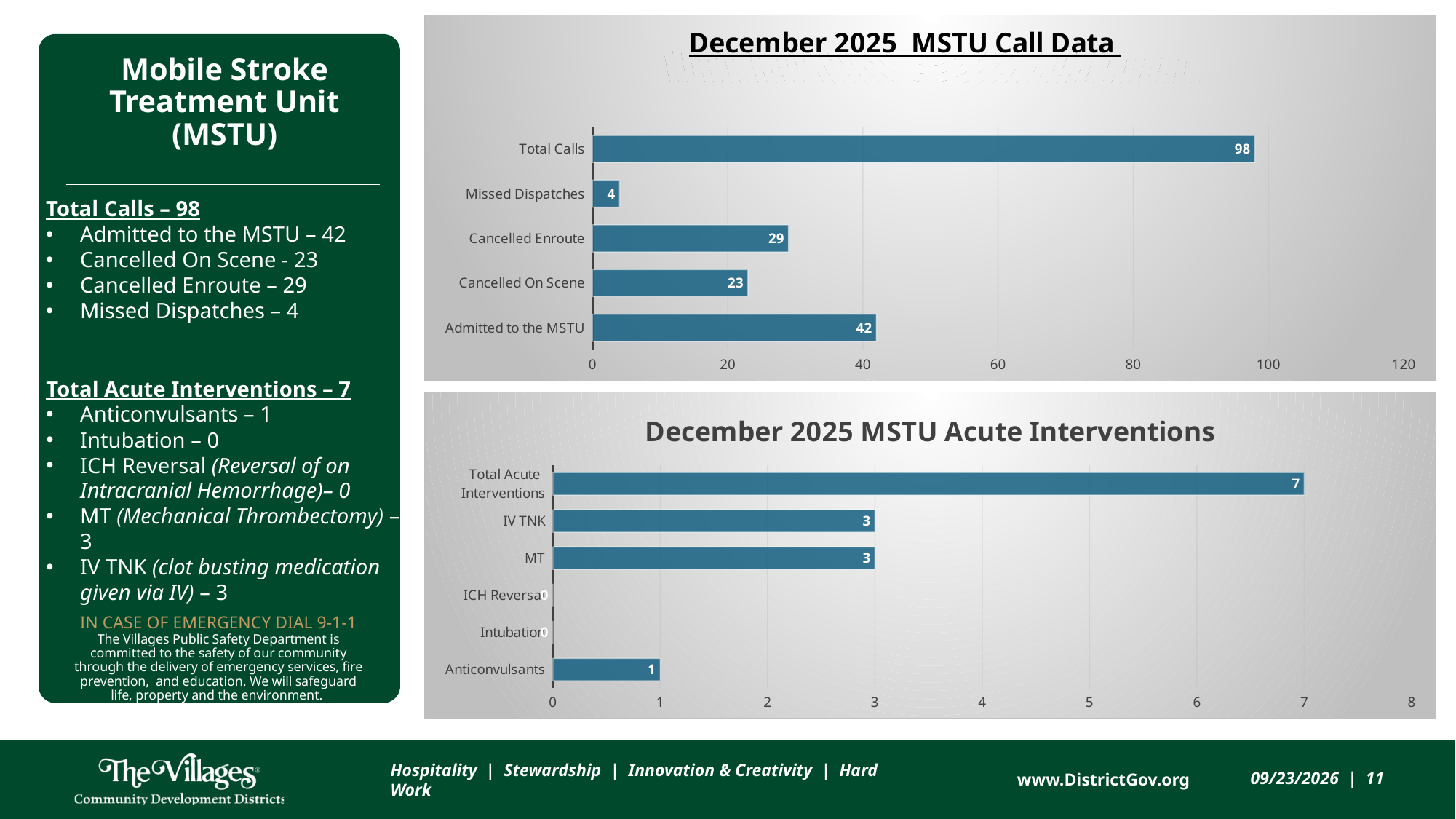
How many categories are shown in the December 2025 MSTU Acute Interventions chart? 6 In the December 2025 MSTU Call Data chart, which category has the lowest value? Missed Dispatches In the December 2025 MSTU Call Data chart, what is the value for Cancelled Enroute? 29 In the December 2025 MSTU Acute Interventions chart, what is the difference between Total Acute Interventions and MT? 4 In the December 2025 MSTU Acute Interventions chart, what is the value for Anticonvulsants? 1 In the December 2025 MSTU Acute Interventions chart, what is the value for IV TNK? 3 In the December 2025 MSTU Call Data chart, what is the difference between Admitted to the MSTU and Cancelled On Scene? 19 In the December 2025 MSTU Acute Interventions chart, what is the value for Total Acute Interventions? 7 How many categories are shown in the December 2025 MSTU Call Data chart? 5 What kind of chart is the December 2025 MSTU Call Data chart? Bar chart In the December 2025 MSTU Call Data chart, what is the value for Total Calls? 98 In the December 2025 MSTU Call Data chart, which is larger, Cancelled Enroute or Cancelled On Scene? Cancelled Enroute